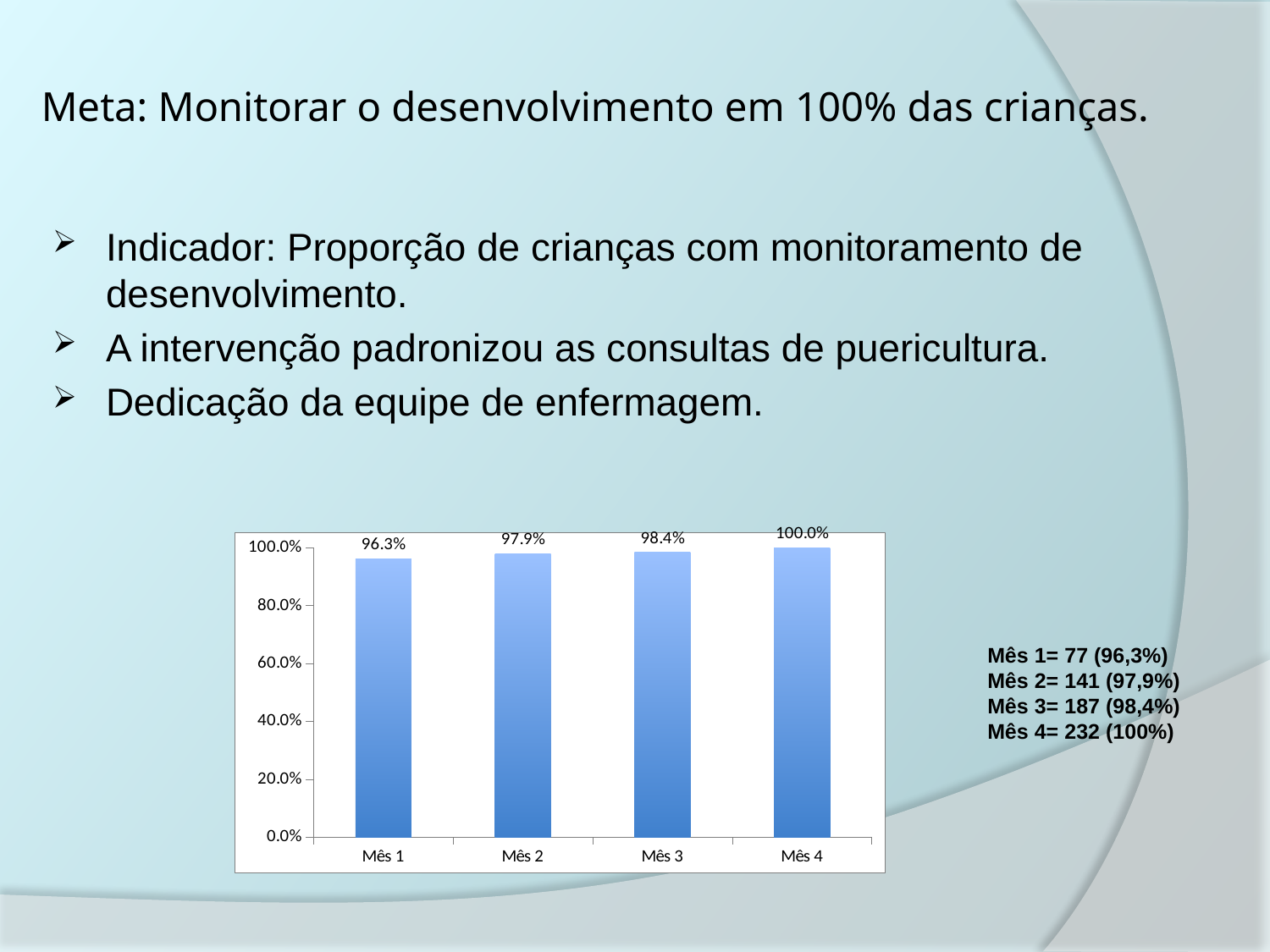
What is the value for Mês 4? 100.0% Which month has the highest value? Mês 4 What is the value for Mês 3? 98.4% What is the value for Mês 1? 96.3% Do the values rise or fall from Mês 1 to Mês 4? Rise What kind of chart is shown on the slide? Bar chart How many months are shown on the x axis? 4 What is the value for Mês 2? 97.9% What is the difference between the values for Mês 3 and Mês 2? 0.5% Which month has the lowest value? Mês 1 Is the value for Mês 2 greater or less than 80.0%? greater What is the difference between the values for Mês 4 and Mês 1? 3.7%